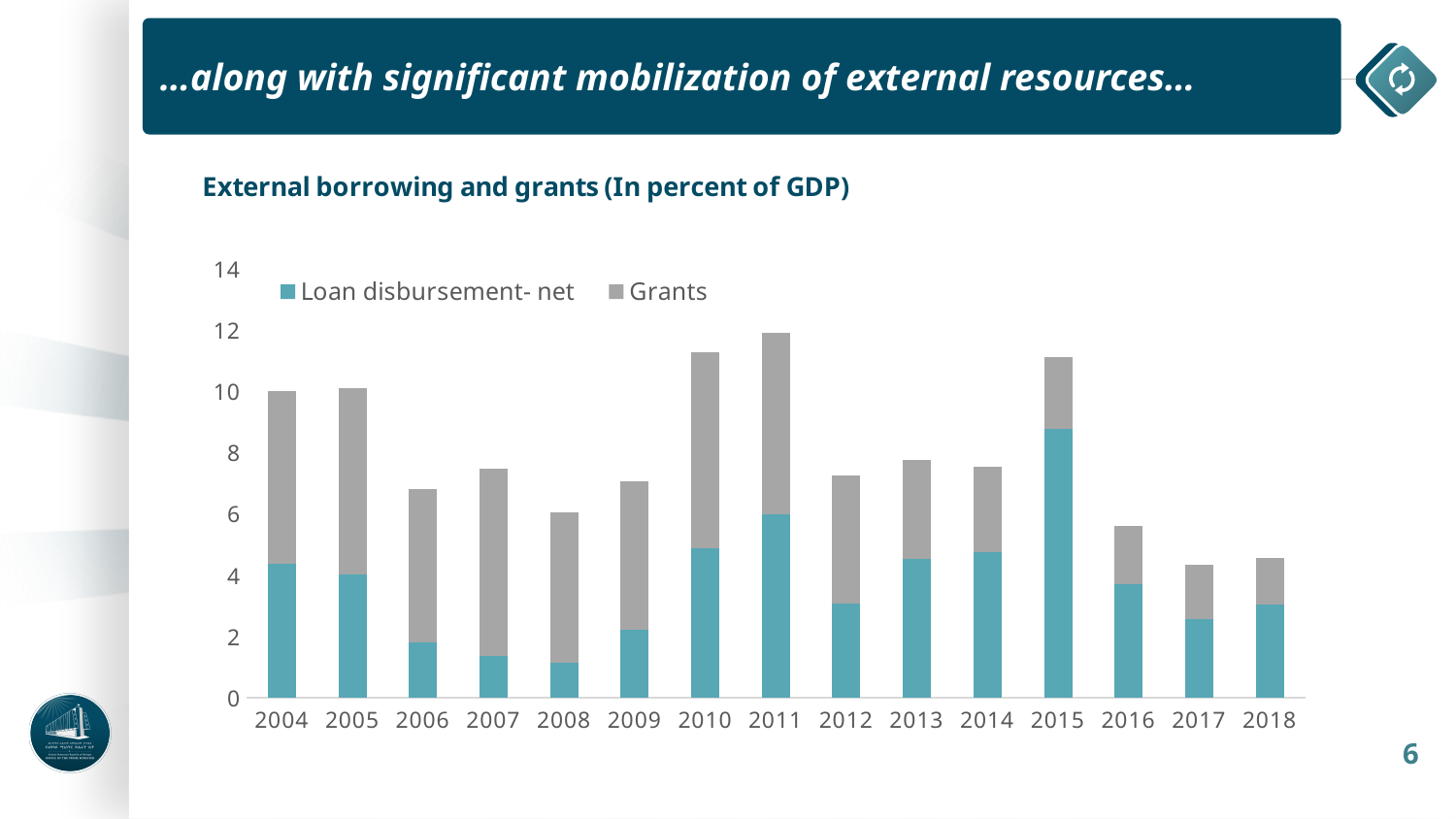
Do the total bar heights rise or fall from 2015 to 2018? fall Is the Loan disbursement- net value for 2008 greater or less than 2? less Is the total bar height for 2010 greater or less than 10? greater What is the title of the chart? External borrowing and grants (In percent of GDP) How many years are shown on the x axis? 15 What kind of chart is shown on the slide? Stacked bar chart Is the Loan disbursement- net value for 2015 greater or less than 8? greater Which year has the highest total of loan disbursement and grants? 2011 Which is larger, the total bar for 2010 or the total bar for 2012? 2010 Which year has the highest value for Loan disbursement- net? 2015 How many series does the legend list? 2